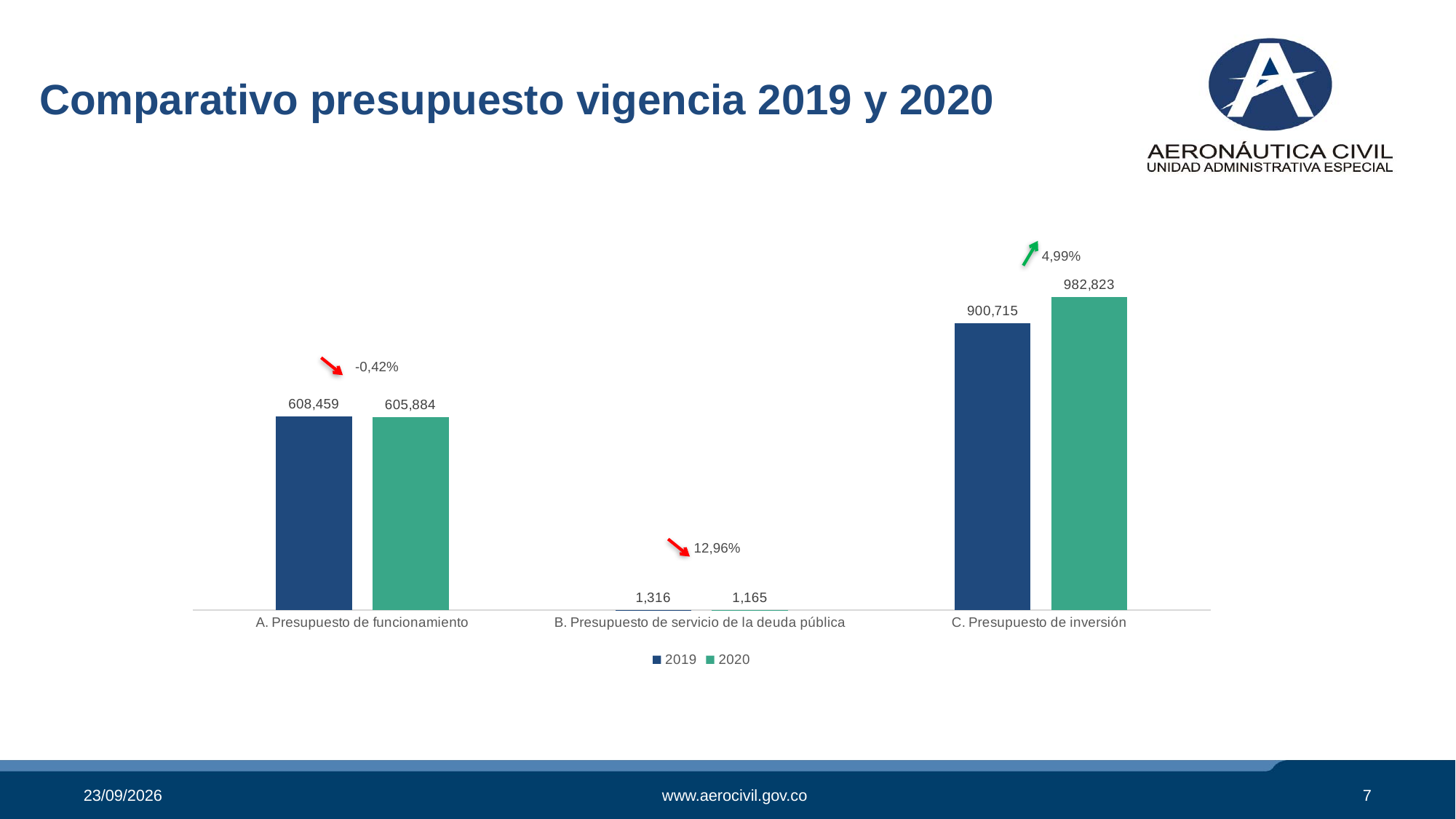
What is the 2019 value for C. Presupuesto de inversión? 900,715 How many categories are shown on the x axis of the chart? 3 What is the 2020 value for C. Presupuesto de inversión? 982,823 What is the 2019 value for B. Presupuesto de servicio de la deuda pública? 1,316 What is the 2020 value for A. Presupuesto de funcionamiento? 605,884 How many series does the legend list? 2 What is the difference between the 2020 and 2019 values for C. Presupuesto de inversión? 82,108 Which category has the highest 2020 value? C. Presupuesto de inversión For A. Presupuesto de funcionamiento, which is larger: the 2019 value or the 2020 value? 2019 What kind of chart is shown on the slide? Bar chart Which category has the lowest 2019 value? B. Presupuesto de servicio de la deuda pública What is the difference between the 2019 and 2020 values for A. Presupuesto de funcionamiento? 2,575